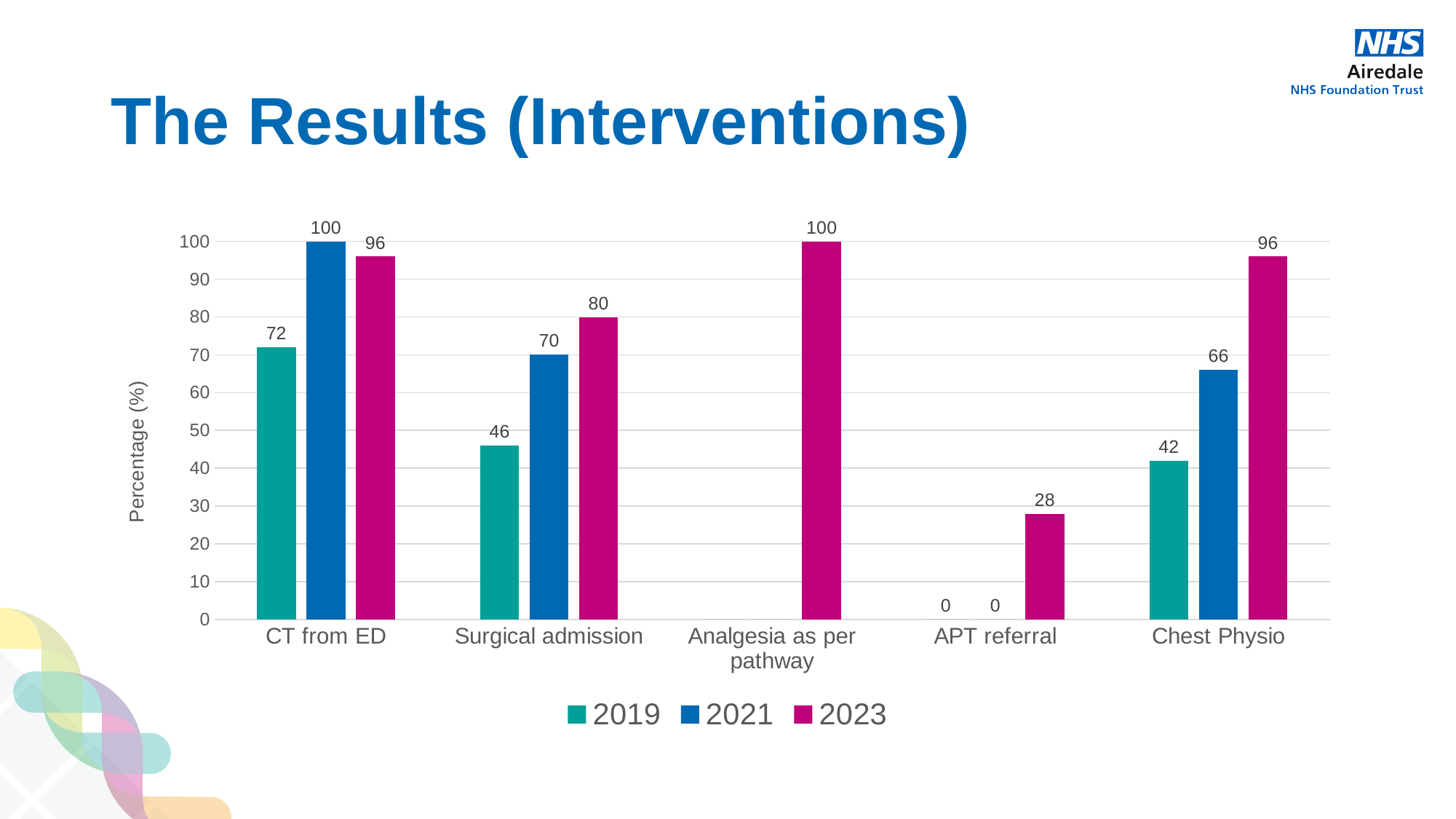
What is the label of the vertical axis? Percentage (%) What kind of chart is shown on the slide? Bar chart What is the 2023 value for APT referral? 28 Which is larger: the 2021 value for Surgical admission or the 2021 value for Chest Physio? Surgical admission What is the 2023 value for Surgical admission? 80 What is the difference between the 2023 and 2019 values for Chest Physio? 54 What is the 2019 value for Chest Physio? 42 What is the 2021 value for CT from ED? 100 Which category has the highest 2023 value? Analgesia as per pathway How many series does the legend list? 3 How many categories are shown on the x axis? 5